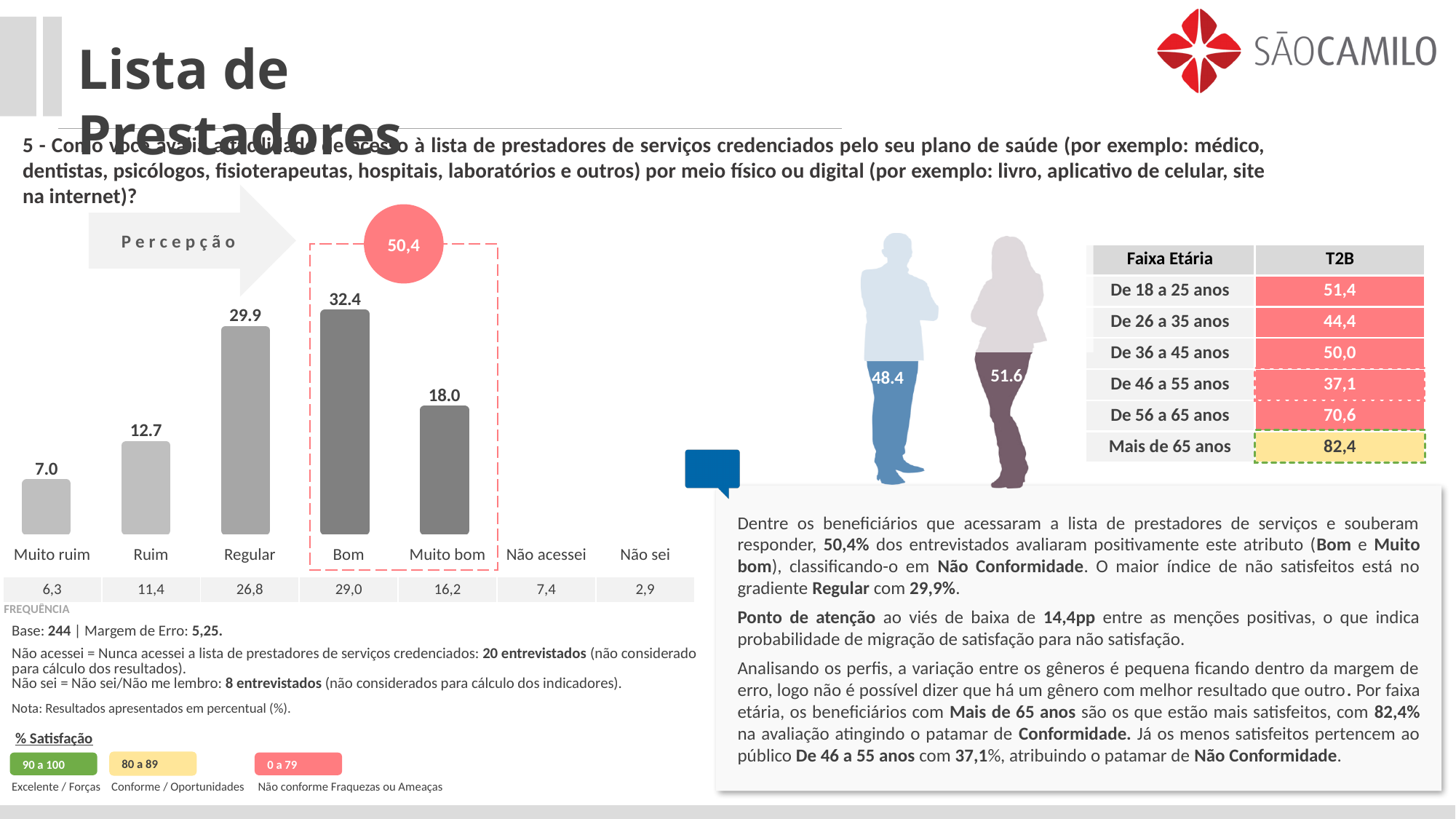
What type of chart is used to show the evaluation of access to the list of providers? bar chart What is the value shown for the 'Bom' bar? 32.4 What is the value shown for the 'Muito bom' bar? 18.0 Which category has the lowest bar in the chart? Muito ruim What value is shown in the red circle above the 'Bom' and 'Muito bom' bars? 50,4 What is the difference between the values for 'Regular' and 'Ruim'? 17.2 Which category has the highest bar in the chart? Bom What is the difference between the values for 'Bom' and 'Muito bom'? 14.4 What is the value shown for the 'Muito ruim' bar? 7.0 Which is larger, the value for 'Regular' or the value for 'Muito bom'? Regular How many bars are plotted in the chart? 5 What is the value shown for the 'Regular' bar? 29.9